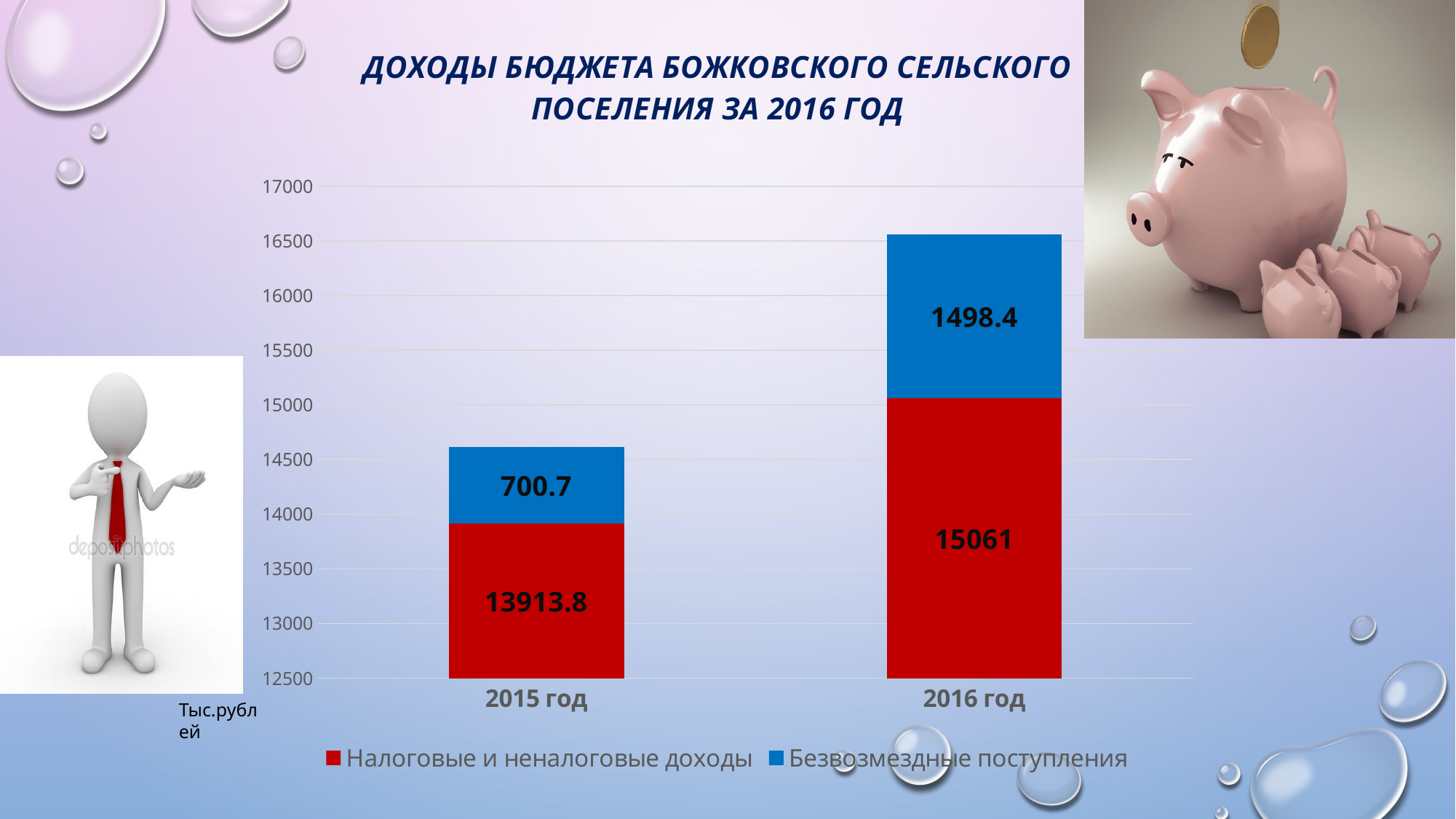
What is the value of Безвозмездные поступления for 2015 год? 700.7 Which colour represents Безвозмездные поступления in the chart? Blue What is the difference between Налоговые и неналоговые доходы in 2016 год and 2015 год? 1147.2 What is the value of Безвозмездные поступления for 2016 год? 1498.4 What is the total of the stacked bar for 2016 год? 16559.4 What type of chart is shown on the slide? Stacked bar chart What is the difference between Безвозмездные поступления in 2016 год and 2015 год? 797.7 How many series does the legend list? 2 What is the value of Налоговые и неналоговые доходы for 2015 год? 13913.8 What is the value of Налоговые и неналоговые доходы for 2016 год? 15061 Which year has the higher value for Налоговые и неналоговые доходы? 2016 год Which year has the lower value for Безвозмездные поступления? 2015 год